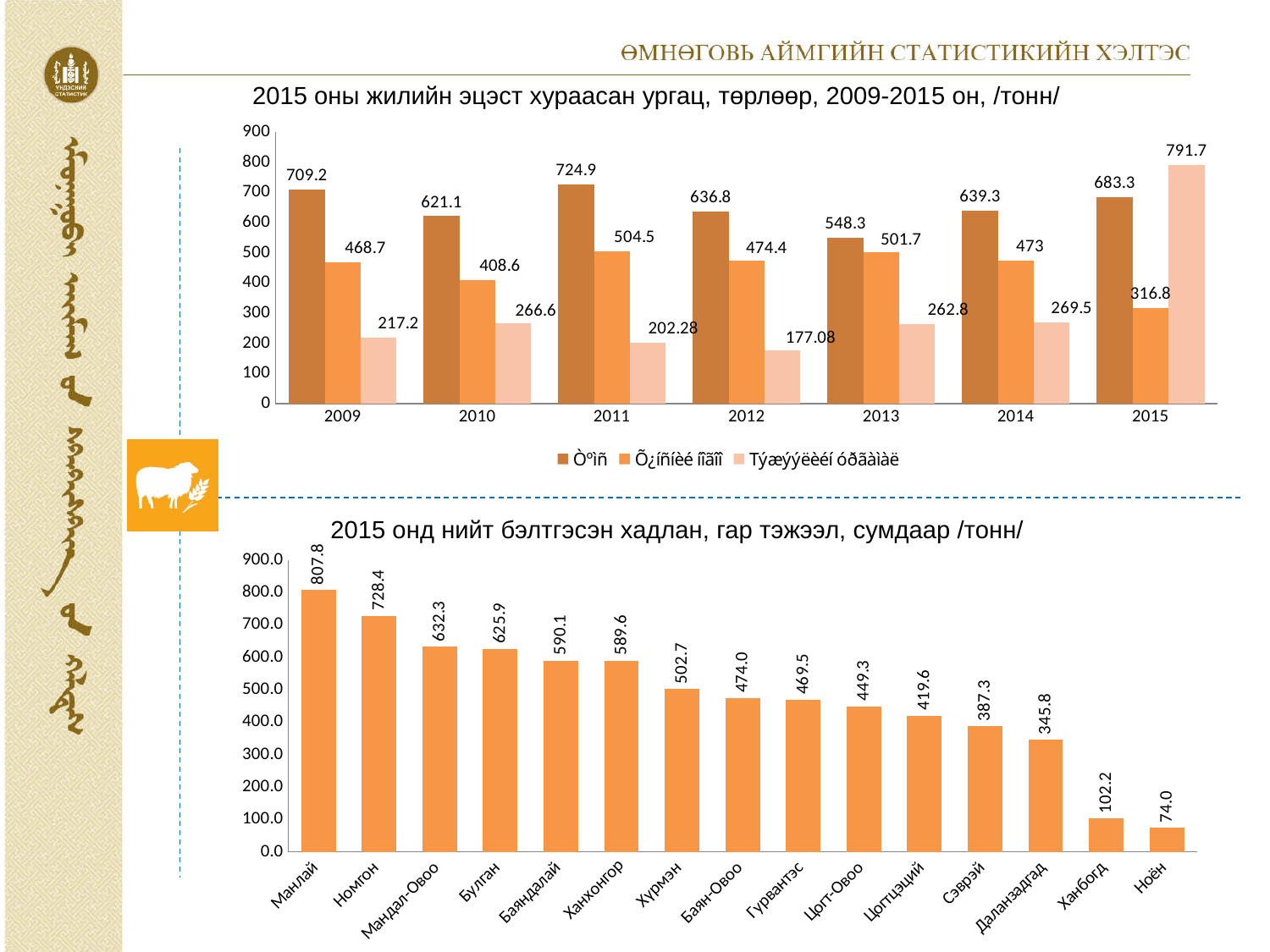
In the top chart, what is the value of the light peach (third) bar for 2015? 791.7 In the bottom chart, which category has the lowest value? Ноён In the top chart, which year has the lowest value for the light peach (third) series? 2012 In the top chart, how many series does the legend list? 3 In the bottom chart, which is larger, the value for Хүрмэн or the value for Сэврэй? Хүрмэн What kind of chart is the bottom chart? Bar chart In the top chart, what is the value of the dark brown (first) bar for 2011? 724.9 In the top chart, which year has the highest value for the dark brown (first) series? 2011 In the top chart, what is the difference between the dark brown bar and the orange bar for 2009? 240.5 In the bottom chart, what is the value for Даланзадгад? 345.8 In the bottom chart, how many categories are shown? 15 In the top chart, what is the value of the orange (second) bar for 2013? 501.7